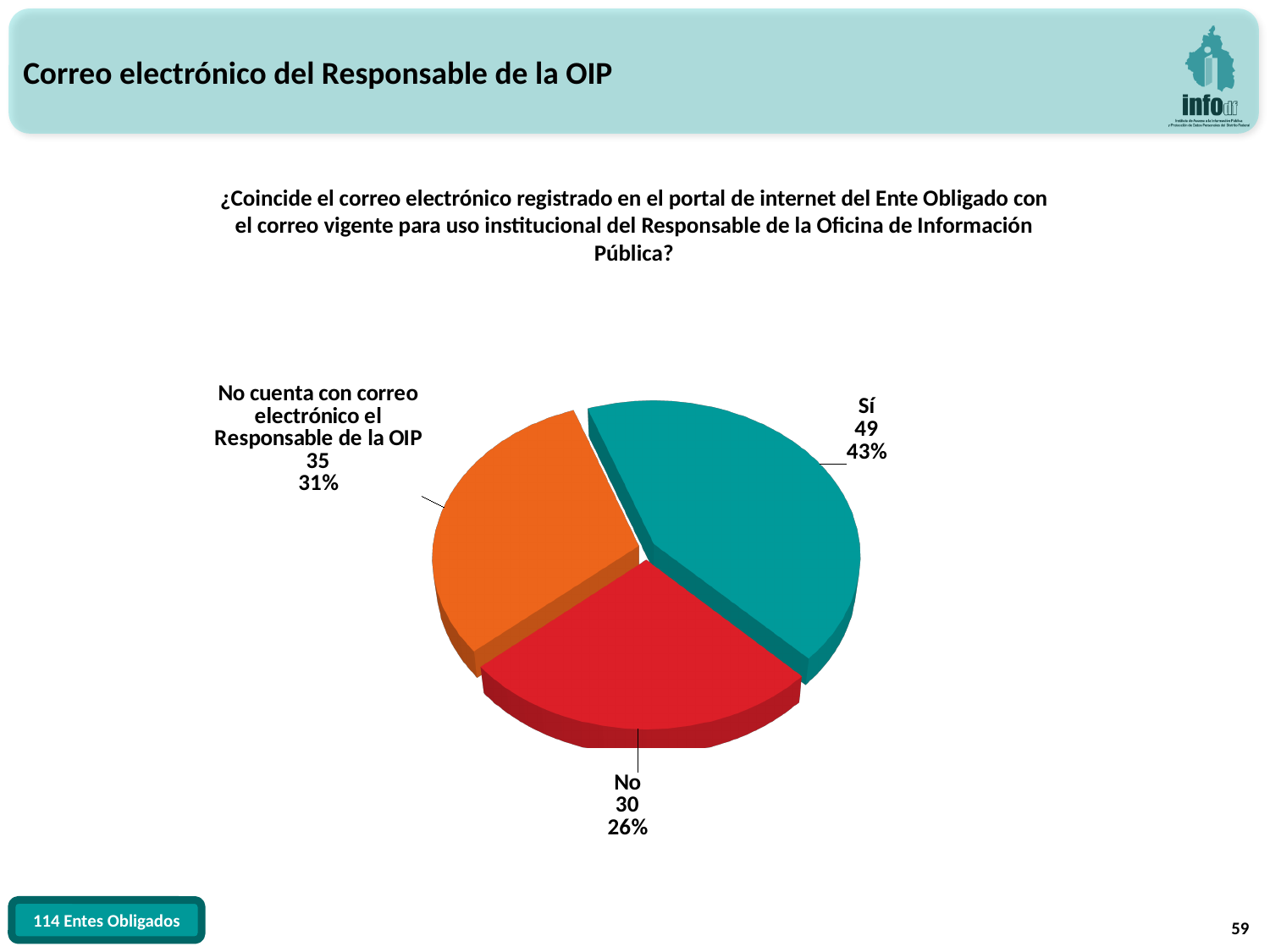
What percentage does the 'No' slice represent? 26% What percentage does the 'Sí' slice represent? 43% What is the difference between the counts for 'Sí' and 'No'? 19 What is the count for the 'Sí' slice? 49 What is the count for 'No cuenta con correo electrónico el Responsable de la OIP'? 35 What is the total of the three slice counts? 114 Which category has the largest slice? Sí How many slices does the pie chart have? 3 What kind of chart is shown on the slide? pie chart Which is larger, the count for 'No' or the count for 'No cuenta con correo electrónico el Responsable de la OIP'? No cuenta con correo electrónico el Responsable de la OIP Which category has the smallest slice? No What colour is the 'Sí' slice? teal